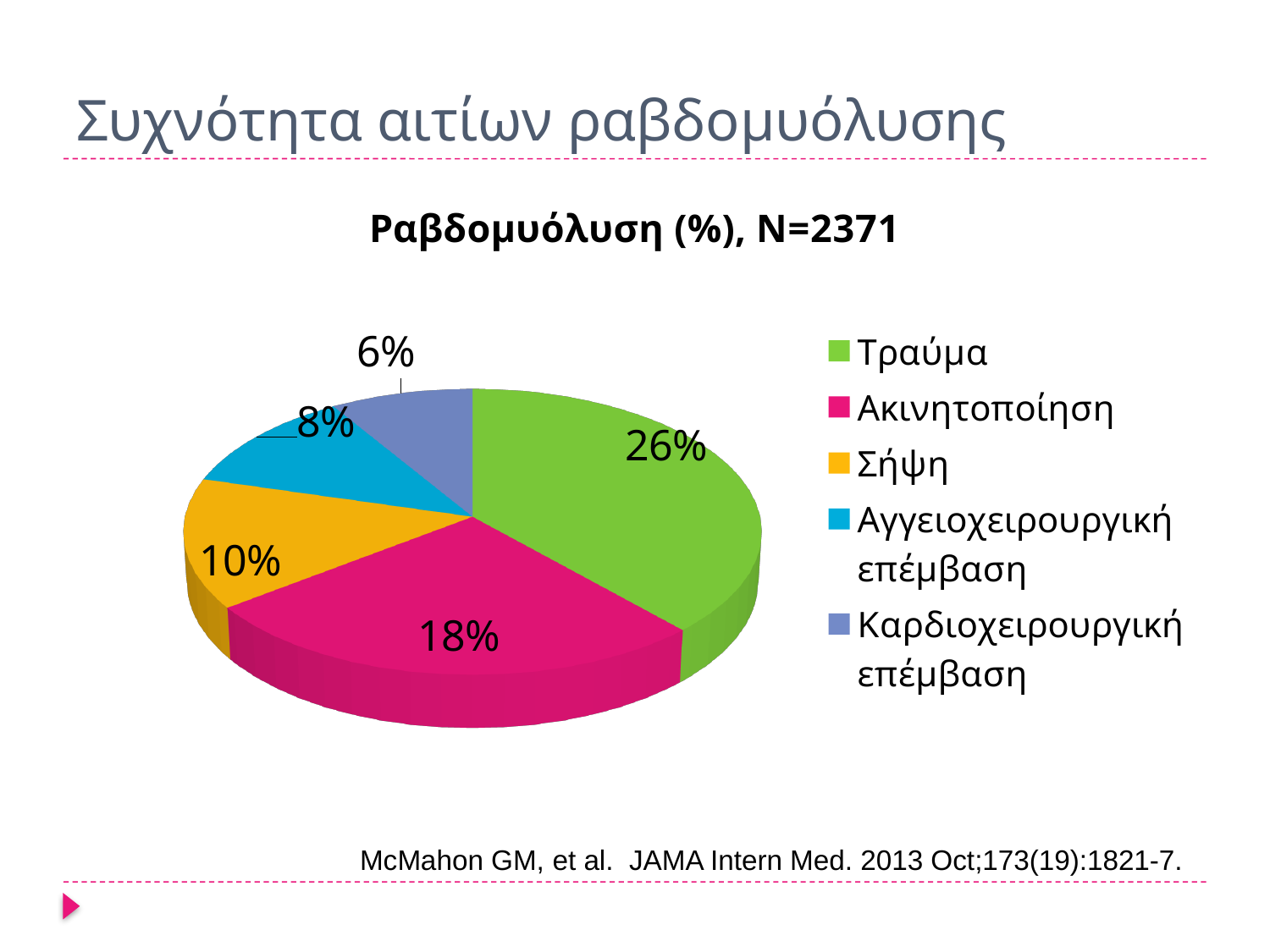
Which category has the largest slice? Τραύμα What percentage is shown for Καρδιοχειρουργική επέμβαση? 6% What percentage is shown for Τραύμα? 26% What is the difference in percentage points between Τραύμα and Ακινητοποίηση? 8 What percentage is shown for Ακινητοποίηση? 18% What kind of chart is shown on the slide? Pie chart How many categories does the legend list? 5 What percentage is shown for Αγγειοχειρουργική επέμβαση? 8% Which category has the smallest slice? Καρδιοχειρουργική επέμβαση Which is larger, Σήψη or Αγγειοχειρουργική επέμβαση? Σήψη What is the chart's title? Ραβδομυόλυση (%), N=2371 What percentage is shown for Σήψη? 10%